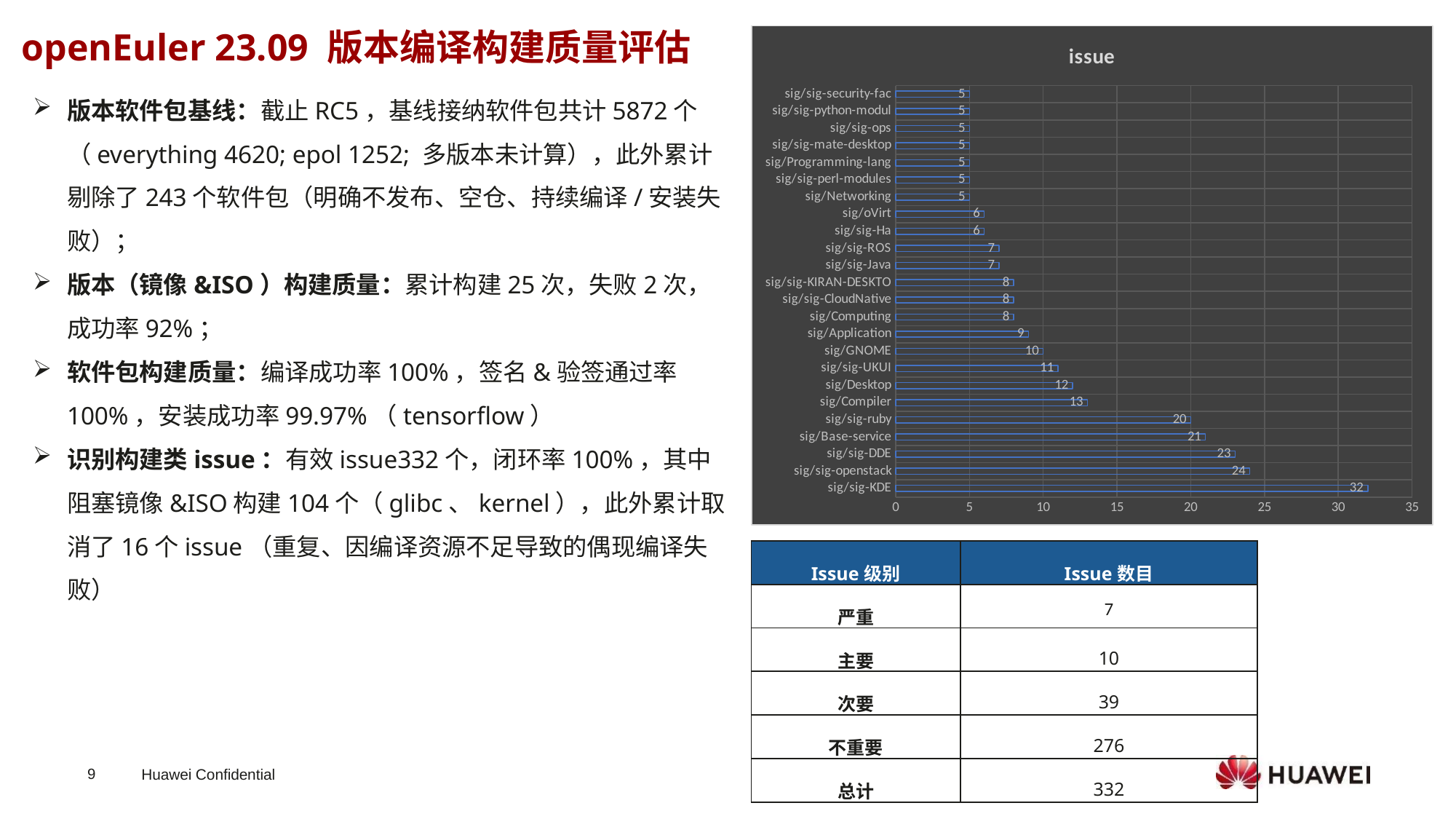
What is the value for sig/Base-service? 21 Is the value for sig/sig-openstack greater or less than 20? greater What is the value for sig/sig-KDE? 32 What is the difference between the values for sig/sig-KDE and sig/sig-openstack? 8 What is the title of the chart? issue Which is larger, the value for sig/Desktop or the value for sig/sig-UKUI? sig/Desktop What is the difference between the values for sig/sig-DDE and sig/sig-ruby? 3 How many categories are shown in the chart? 24 What is the value for sig/Compiler? 13 Which category has the highest value? sig/sig-KDE What kind of chart is shown on the slide? bar chart What is the value for sig/GNOME? 10